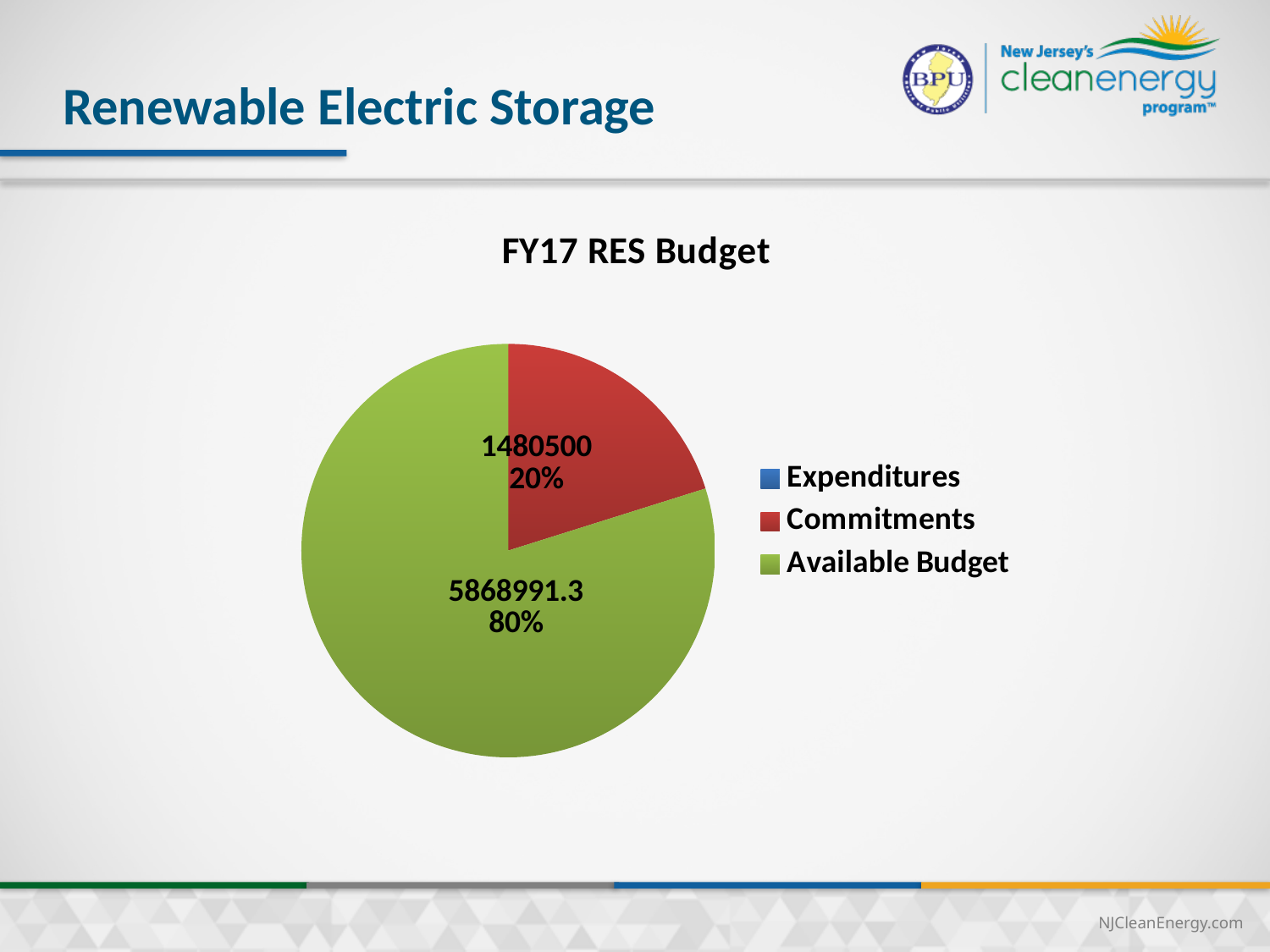
What is the title of the chart? FY17 RES Budget What is the value shown for Available Budget in the FY17 RES Budget pie chart? 5868991.3 What colour represents Available Budget in the FY17 RES Budget pie chart? Green Which category has the largest slice in the FY17 RES Budget pie chart? Available Budget What type of chart is shown on the slide? Pie chart What is the value shown for Commitments in the FY17 RES Budget pie chart? 1480500 What percentage of the FY17 RES Budget pie is Commitments? 20% What percentage of the FY17 RES Budget pie is Available Budget? 80% What is the difference between the Available Budget value and the Commitments value in the FY17 RES Budget pie chart? 4388491.3 How many entries does the legend of the FY17 RES Budget chart list? 3 Which is larger in the FY17 RES Budget pie chart, Commitments or Available Budget? Available Budget What is the sum of the Commitments and Available Budget values shown in the FY17 RES Budget pie chart? 7349491.3